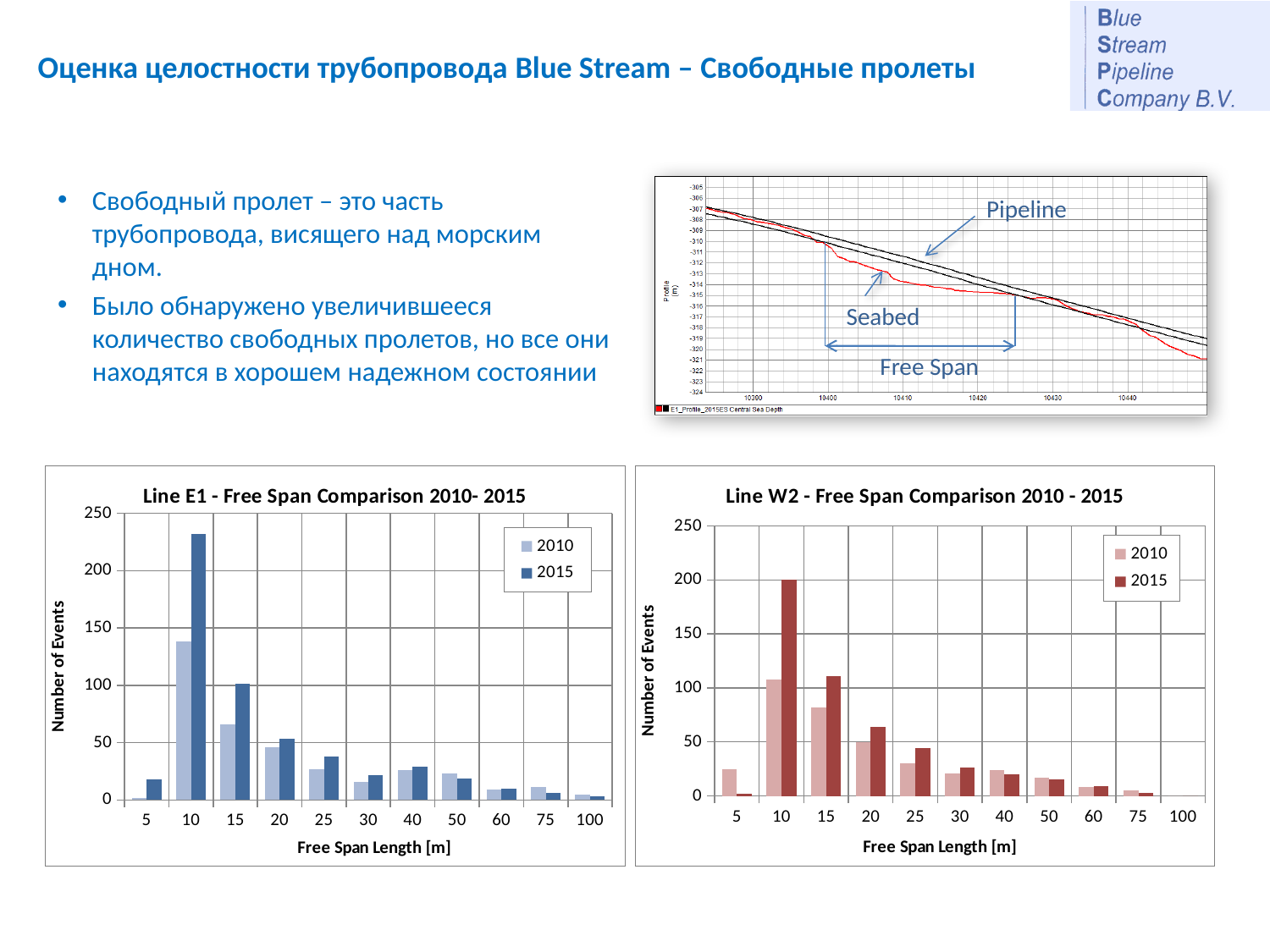
In the 'Line E1 - Free Span Comparison 2010- 2015' chart, is the 2015 value for free span length 10 greater or less than 200? greater In the 'Line E1 - Free Span Comparison 2010- 2015' chart, at free span length 15, which series has more events, 2010 or 2015? 2015 In the 'Line W2 - Free Span Comparison 2010 - 2015' chart, at free span length 5, which series has more events, 2010 or 2015? 2010 In the 'Line E1 - Free Span Comparison 2010- 2015' chart, which free span length has the highest number of events for 2015? 10 In the 'Line E1 - Free Span Comparison 2010- 2015' chart, is the 2010 value for free span length 10 greater or less than 150? less In the 'Line W2 - Free Span Comparison 2010 - 2015' chart, do the 2015 values generally rise or fall as free span length increases from 10 to 100? fall How many series does the legend of the 'Line W2 - Free Span Comparison 2010 - 2015' chart list? 2 In the 'Line W2 - Free Span Comparison 2010 - 2015' chart, which free span length has the highest number of events for 2015? 10 What kind of chart is the 'Line E1 - Free Span Comparison 2010- 2015' chart? bar chart In the 'Line W2 - Free Span Comparison 2010 - 2015' chart, is the 2015 value for free span length 10 greater or less than 150? greater What is the x-axis title of the 'Line E1 - Free Span Comparison 2010- 2015' chart? Free Span Length [m] How many free span length categories are shown on the x axis of the 'Line E1 - Free Span Comparison 2010- 2015' chart? 11